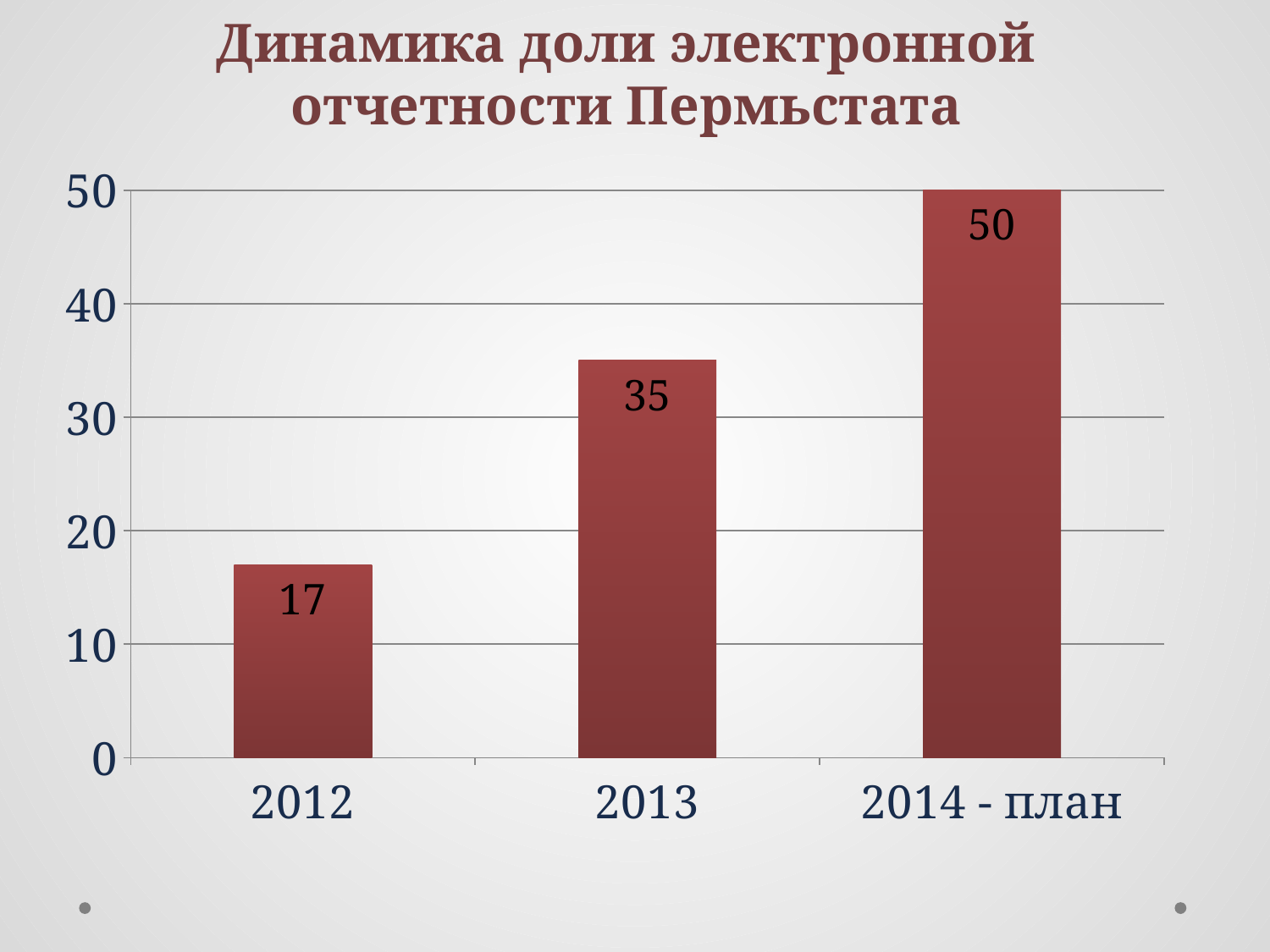
What is the difference between the values for 2014 - план and 2013? 15 What is the value for 2014 - план? 50 Which category has the lowest value? 2012 Do the values rise or fall from 2012 to 2014 - план? rise Which is larger, the value for 2012 or the value for 2013? 2013 Which category has the highest value? 2014 - план What kind of chart is shown on the slide? bar chart How many categories are shown on the x axis? 3 What is the value for 2013? 35 What is the difference between the values for 2013 and 2012? 18 What is the value for 2012? 17 Is the value for 2013 greater or less than 30? greater